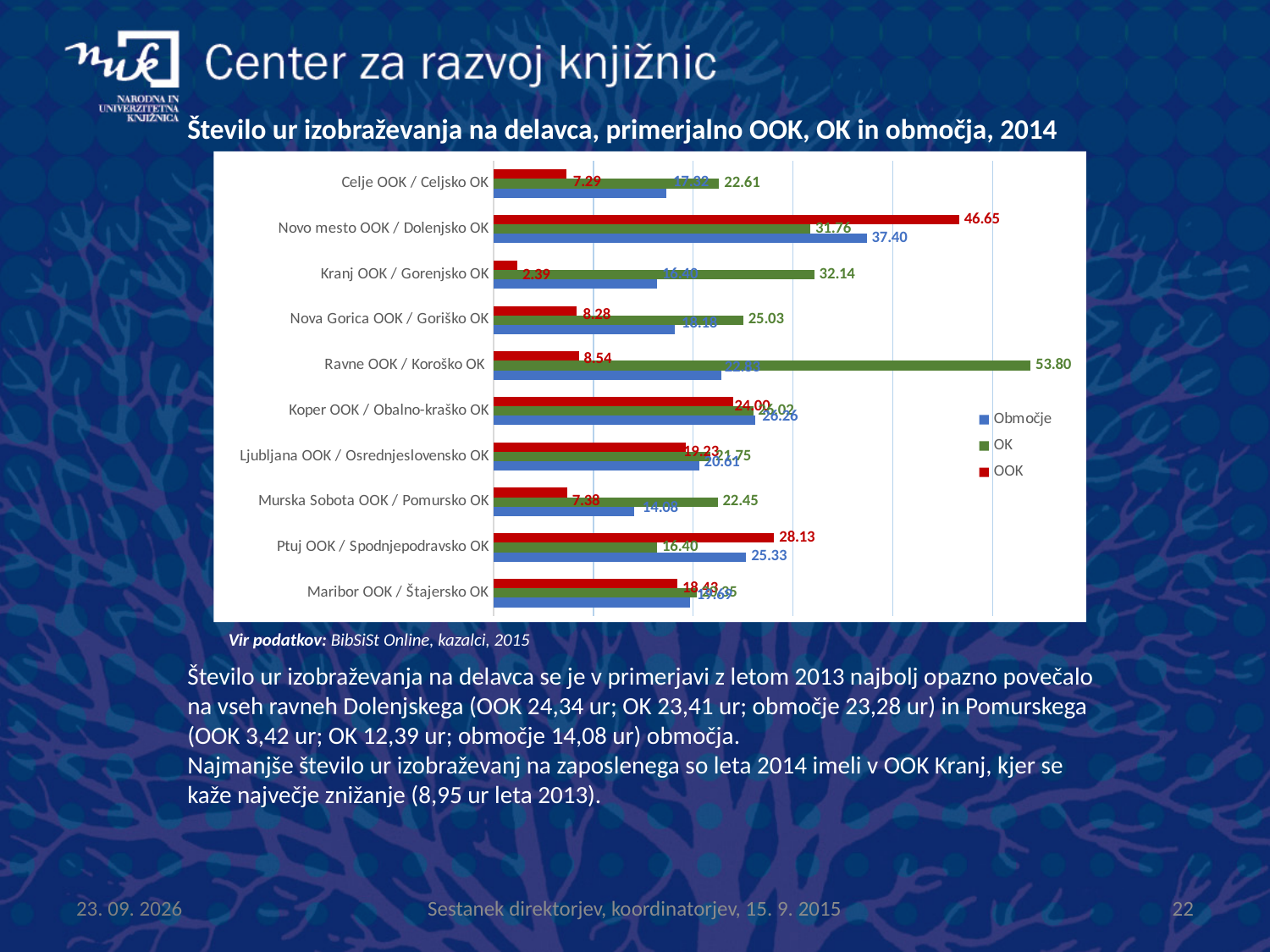
What is the OOK value for Kranj OOK / Gorenjsko OK? 2.39 What is the OK value for Ravne OOK / Koroško OK? 53.80 What is the Območje value for Ptuj OOK / Spodnjepodravsko OK? 25.33 What is the OOK value for Novo mesto OOK / Dolenjsko OK? 46.65 Which category has the lowest OOK value? Kranj OOK / Gorenjsko OK For Ptuj OOK / Spodnjepodravsko OK, which is larger: the OOK value or the OK value? OOK What are the three series named in the legend? Območje, OK, OOK What is the difference between the OOK and OK values for Novo mesto OOK / Dolenjsko OK? 14.89 How many series does the legend list? 3 Which category has the highest OK value? Ravne OOK / Koroško OK How many categories (library pairs) are shown on the chart? 10 What kind of chart is shown on the slide? bar chart